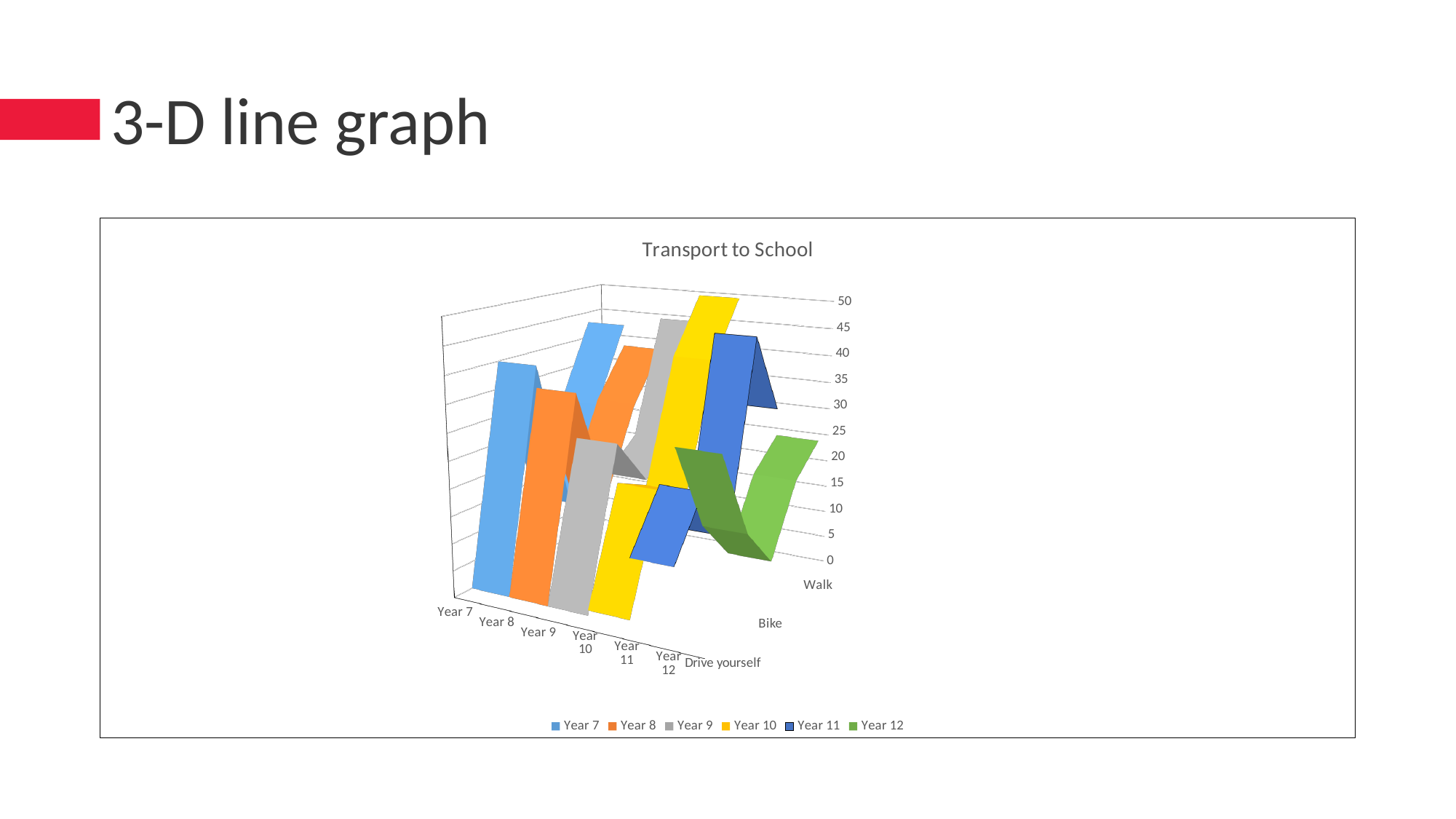
Is the value for Year 12 at Bike greater or less than 20? less What is the title of the chart? Transport to School Is the value for Year 7 at Drive yourself greater or less than 20? less How many transport categories are plotted on the chart? 5 What kind of chart is shown on the slide? 3-D line chart Which series are listed in the legend? Year 7, Year 8, Year 9, Year 10, Year 11, Year 12 How many series does the legend list? 6 What is the highest value shown on the vertical axis? 50